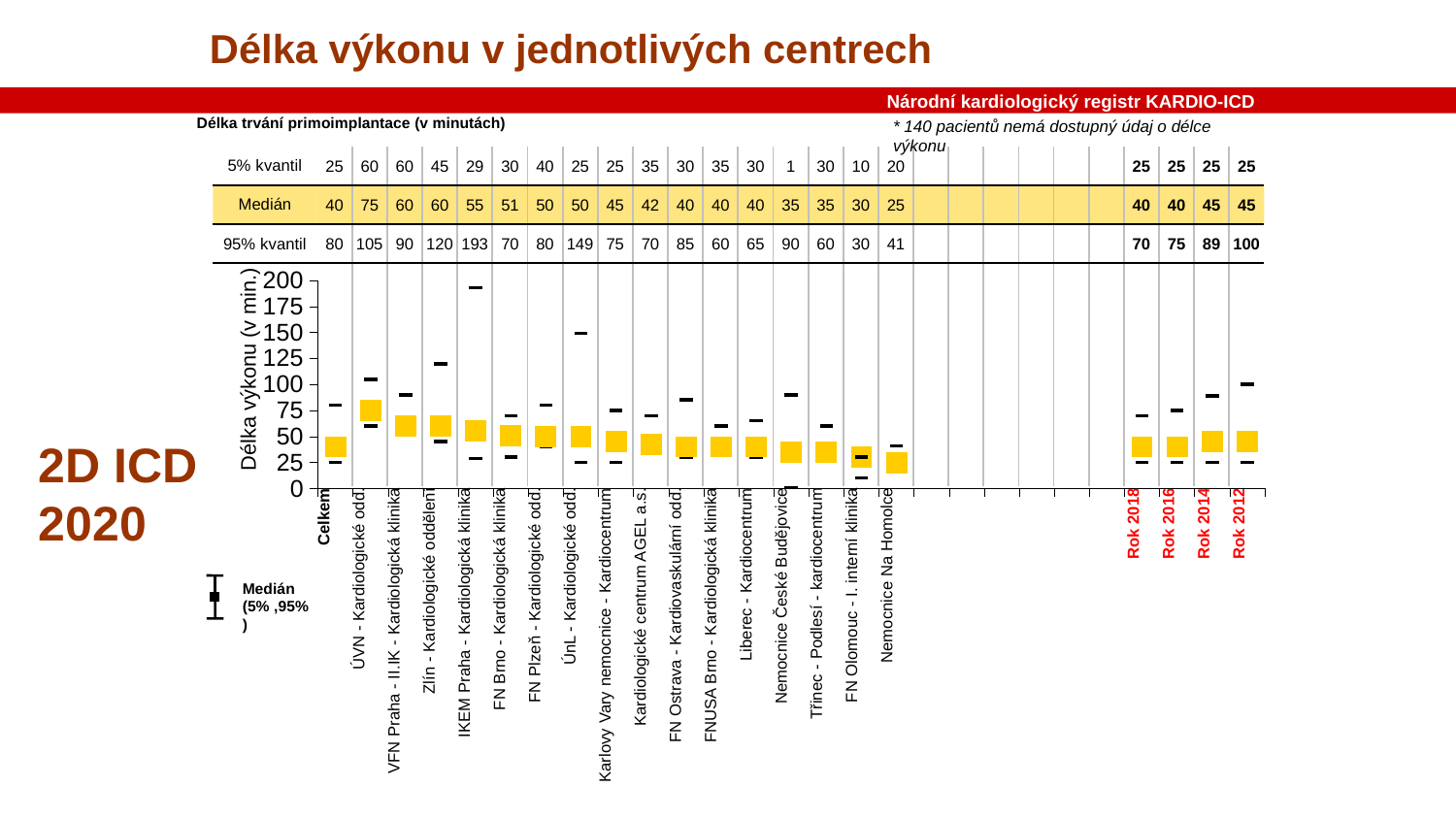
Does the median procedure duration rise or fall from Rok 2012 to Rok 2018? fall Which has a larger 95% kvantil value: Zlín - Kardiologické oddělení or FN Brno - Kardiologická klinika? Zlín - Kardiologické oddělení Which centre has the highest 95% kvantil value? IKEM Praha - Kardiologická klinika What is the median (Medián) value for Celkem? 40 What is the difference between the median for ÚVN - Kardiologické odd. and the median for Celkem? 35 What is the median (Medián) value for Rok 2012? 45 What is the median (Medián) procedure duration for IKEM Praha - Kardiologická klinika? 55 Which centre has the lowest median (Medián) procedure duration? Nemocnice Na Homolce What is the label of the vertical axis of the chart? Délka výkonu (v min.) Which centre has the highest median (Medián) procedure duration? ÚVN - Kardiologické odd. What is the 95% kvantil value for IKEM Praha - Kardiologická klinika? 193 What is the 5% kvantil value for Nemocnice České Budějovice? 1